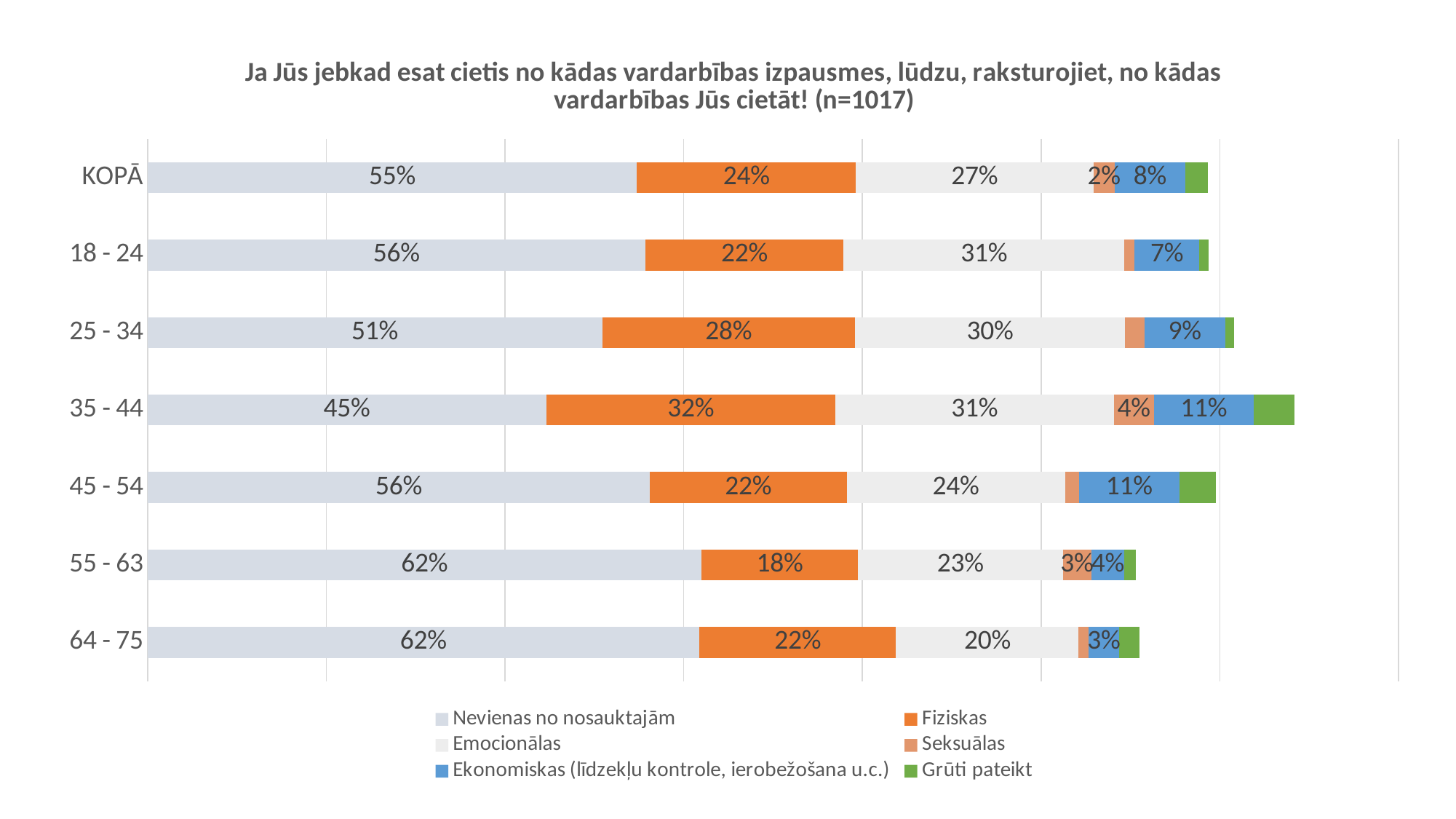
Which age group has the lowest value for 'Nevienas no nosauktajām'? 35 - 44 What is the difference between the 'Fiziskas' values for 25 - 34 and 55 - 63? 10% How many series does the legend list? 6 Which age group has the highest value for 'Fiziskas'? 35 - 44 What sample size (n) is stated in the chart title? n=1017 What type of chart is shown on the slide? Stacked bar chart What is the value of 'Fiziskas' for the 35 - 44 age group? 32% What is the value of 'Emocionālas' for the 18 - 24 age group? 31% What is the value of 'Ekonomiskas (līdzekļu kontrole, ierobežošana u.c.)' for the 25 - 34 age group? 9% How many age groups (including KOPĀ) are shown on the chart? 7 Which is larger: the 'Emocionālas' value for 45 - 54 or for 64 - 75? 45 - 54 What is the value of 'Nevienas no nosauktajām' for the KOPĀ row? 55%